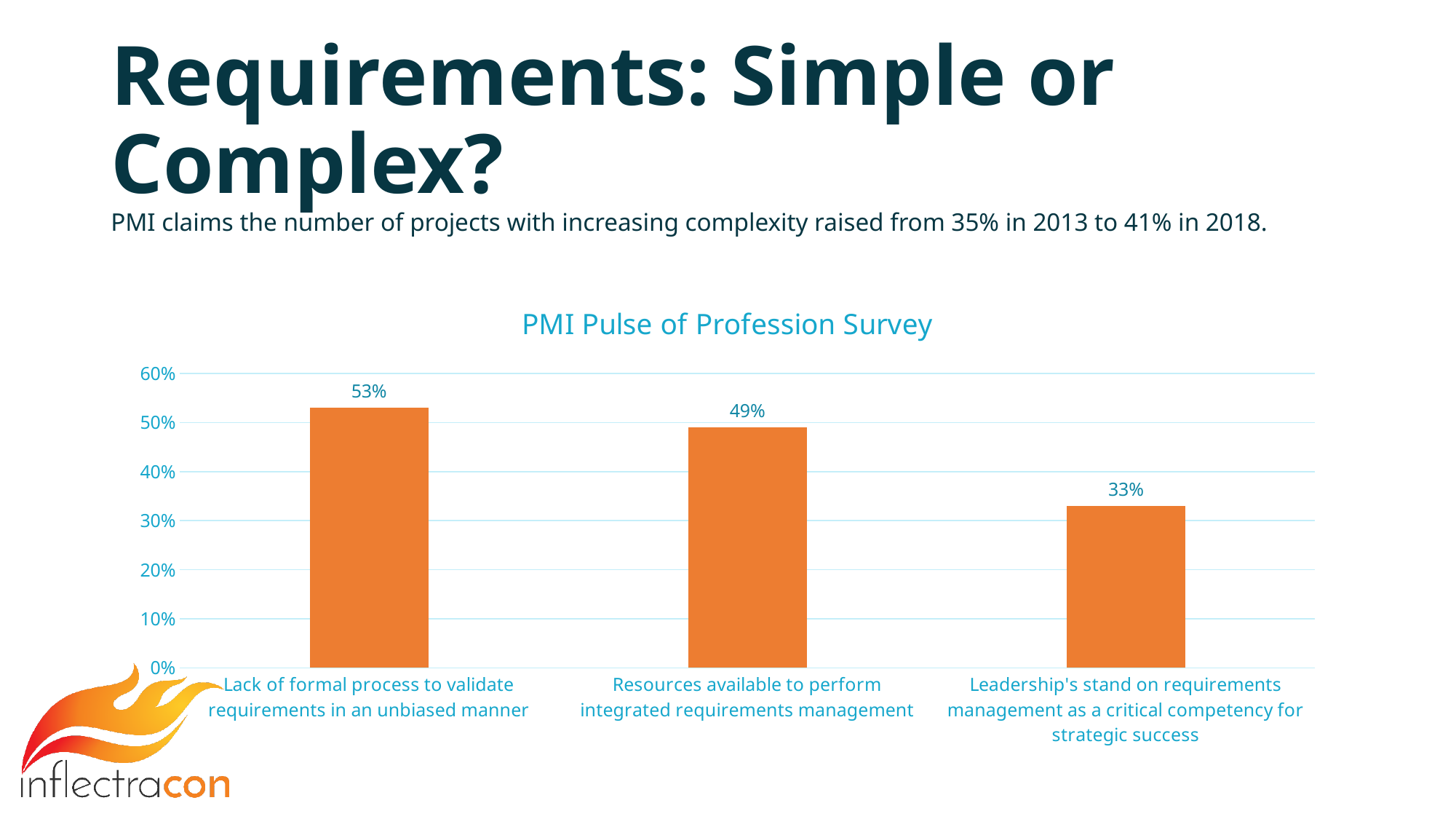
What is the value for 'Leadership's stand on requirements management as a critical competency for strategic success'? 33% How many categories are shown in the chart? 3 What is the difference between the values for 'Lack of formal process to validate requirements in an unbiased manner' and 'Leadership's stand on requirements management as a critical competency for strategic success'? 20% What is the title of the chart? PMI Pulse of Profession Survey What kind of chart is shown on the slide? Bar chart What is the value for 'Lack of formal process to validate requirements in an unbiased manner'? 53% What is the value for 'Resources available to perform integrated requirements management'? 49% Which is larger: the value for 'Resources available to perform integrated requirements management' or the value for 'Leadership's stand on requirements management as a critical competency for strategic success'? Resources available to perform integrated requirements management Which category has the highest value? Lack of formal process to validate requirements in an unbiased manner Is the value for 'Resources available to perform integrated requirements management' greater or less than 40%? greater What is the difference between the values for 'Lack of formal process to validate requirements in an unbiased manner' and 'Resources available to perform integrated requirements management'? 4% Which category has the lowest value? Leadership's stand on requirements management as a critical competency for strategic success